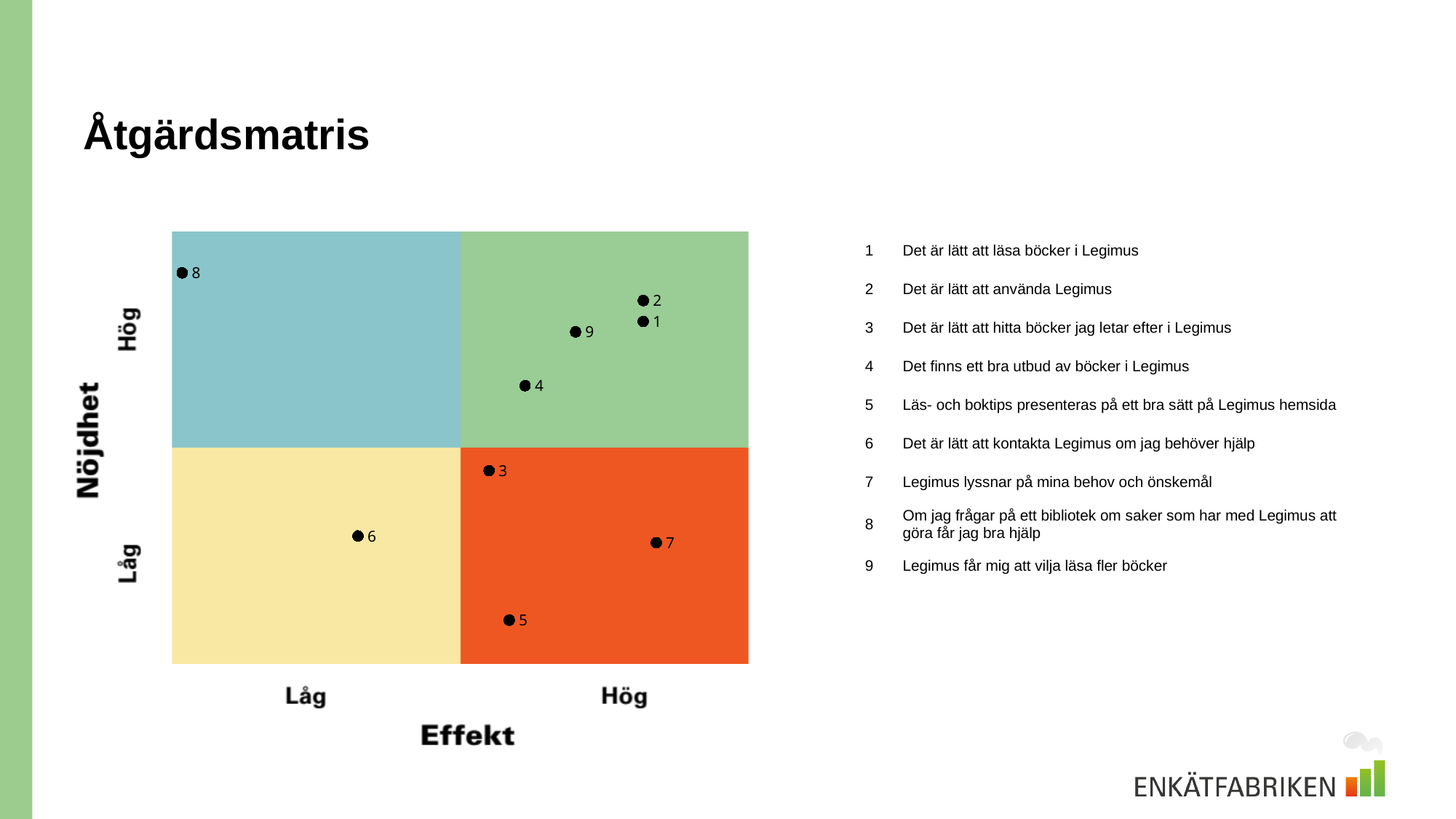
What kind of chart is shown on the slide? Scatter chart (matrix) Which point has higher Nöjdhet, point 3 or point 6? Point 3 Which numbered point lies in the blue quadrant (high Nöjdhet, low Effekt)? 8 Which numbered point has the highest Nöjdhet (satisfaction)? 8 Which point has higher Effekt, point 9 or point 4? Point 9 How many points lie in the green quadrant (high Nöjdhet, high Effekt)? 4 Which numbered point has the lowest Nöjdhet (satisfaction)? 5 What is the label of the vertical axis of the matrix? Nöjdhet What is the title of the slide? Åtgärdsmatris Which numbered point has the lowest Effekt (effect)? 8 Which point has higher Nöjdhet, point 2 or point 4? Point 2 How many numbered points are plotted in the matrix? 9